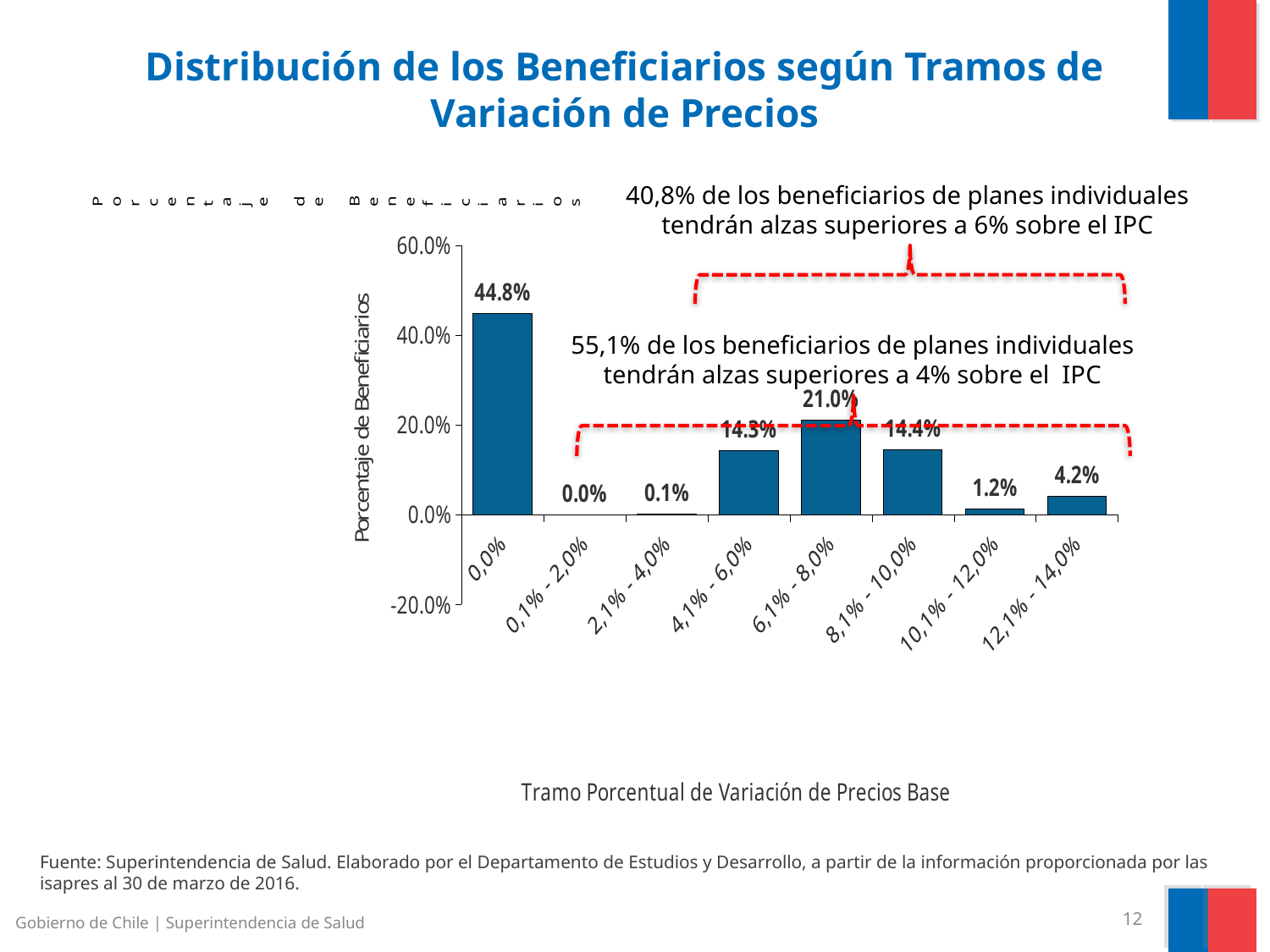
What is the title of the x axis of the chart? Tramo Porcentual de Variación de Precios Base What is the percentage of beneficiaries in the 6,1% - 8,0% bracket? 21.0% How many price variation brackets are shown on the x axis? 8 What is the percentage of beneficiaries in the 0,0% price variation bracket? 44.8% Which bracket has a larger percentage of beneficiaries, 6,1% - 8,0% or 12,1% - 14,0%? 6,1% - 8,0% Which price variation bracket has the highest percentage of beneficiaries? 0,0% What is the difference between the percentage of beneficiaries in the 0,0% bracket and the 6,1% - 8,0% bracket? 23.8% What is the percentage of beneficiaries in the 10,1% - 12,0% bracket? 1.2% What is the percentage of beneficiaries in the 12,1% - 14,0% bracket? 4.2% Which price variation bracket has the lowest percentage of beneficiaries? 0,1% - 2,0% What kind of chart is shown on the slide? bar chart Is the value for the 8,1% - 10,0% bracket greater or less than 20.0%? less